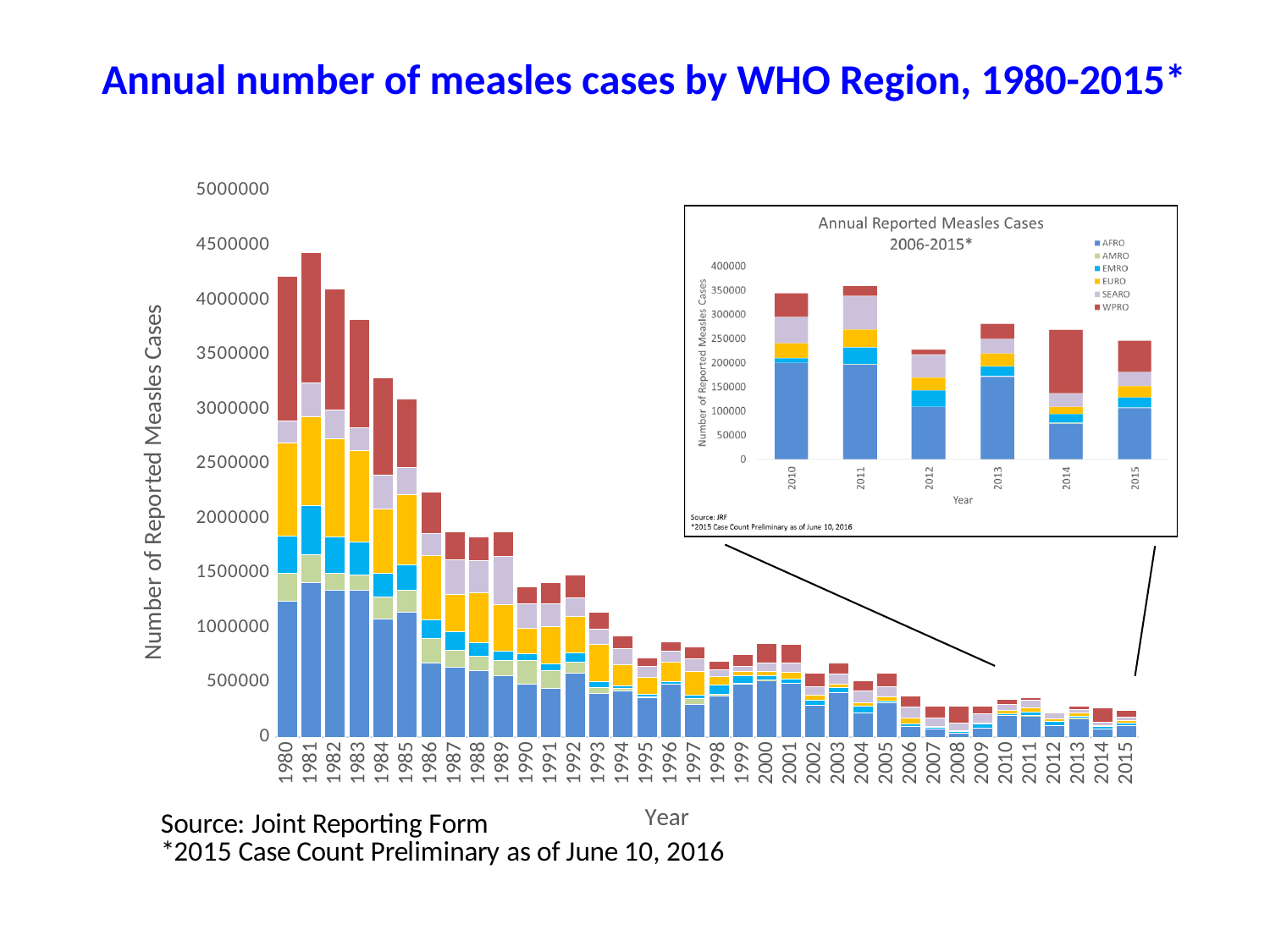
In the main chart (1980-2015), is the total for 1981 greater or less than 4000000? greater In the main chart (1980-2015), do the total reported measles cases generally rise or fall from 1980 to 2015? Fall In the inset chart (Annual Reported Measles Cases 2006-2015*), how many years are plotted? 6 In the inset chart (Annual Reported Measles Cases 2006-2015*), which year has the lowest total number of reported cases? 2012 In the main chart (1980-2015), is the total for 2006 greater or less than 500000? less In the main chart (1980-2015), is the total for 1990 greater or less than 1500000? less What kind of chart is the main chart on the slide (1980-2015)? Stacked bar chart In the inset chart (Annual Reported Measles Cases 2006-2015*), how many series does the legend list? 6 In the main chart (1980-2015), how many years are shown on the x axis? 36 In the inset chart (Annual Reported Measles Cases 2006-2015*), which region is listed first in the legend? AFRO In the main chart (1980-2015), which year has the highest total number of reported measles cases? 1981